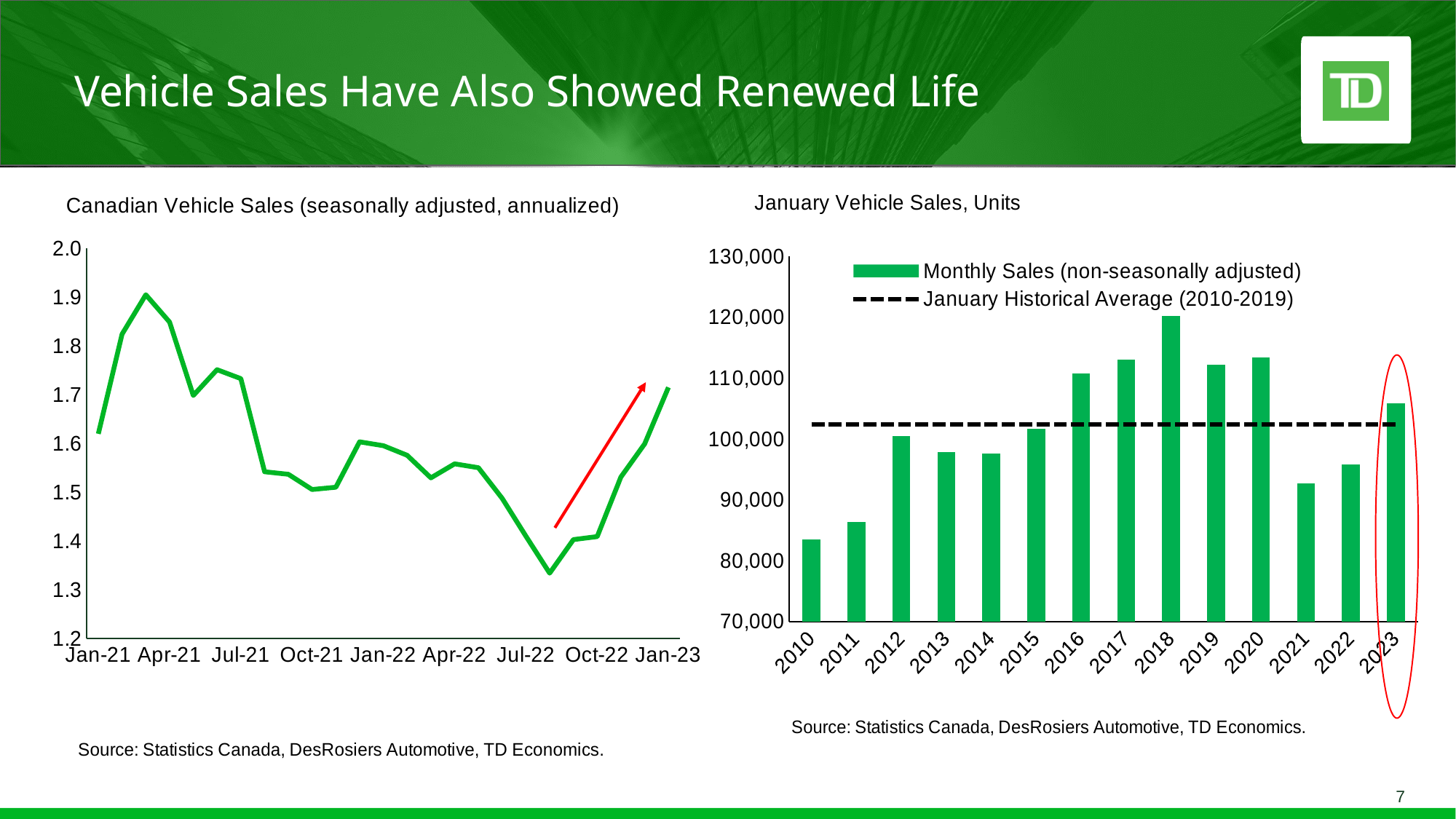
In the 'January Vehicle Sales, Units' chart, which year has the highest monthly sales bar? 2018 In the 'January Vehicle Sales, Units' chart, what does the dashed black line represent according to the legend? January Historical Average (2010-2019) In the 'January Vehicle Sales, Units' chart, is the value for 2017 greater or less than 110,000? greater What kind of chart is the left chart titled 'Canadian Vehicle Sales (seasonally adjusted, annualized)'? line chart In the 'January Vehicle Sales, Units' chart, how many years are shown on the x axis? 14 In the 'January Vehicle Sales, Units' chart, is the value for 2021 greater or less than 100,000? less How many series does the legend of the 'January Vehicle Sales, Units' chart list? 2 In the 'January Vehicle Sales, Units' chart, which is larger, the bar for 2011 or the bar for 2012? 2012 In the 'Canadian Vehicle Sales (seasonally adjusted, annualized)' chart, do values rise or fall between Jul-22 and Jan-23? rise What kind of chart is the right chart titled 'January Vehicle Sales, Units'? bar chart In the 'January Vehicle Sales, Units' chart, which year has the lowest monthly sales bar? 2010